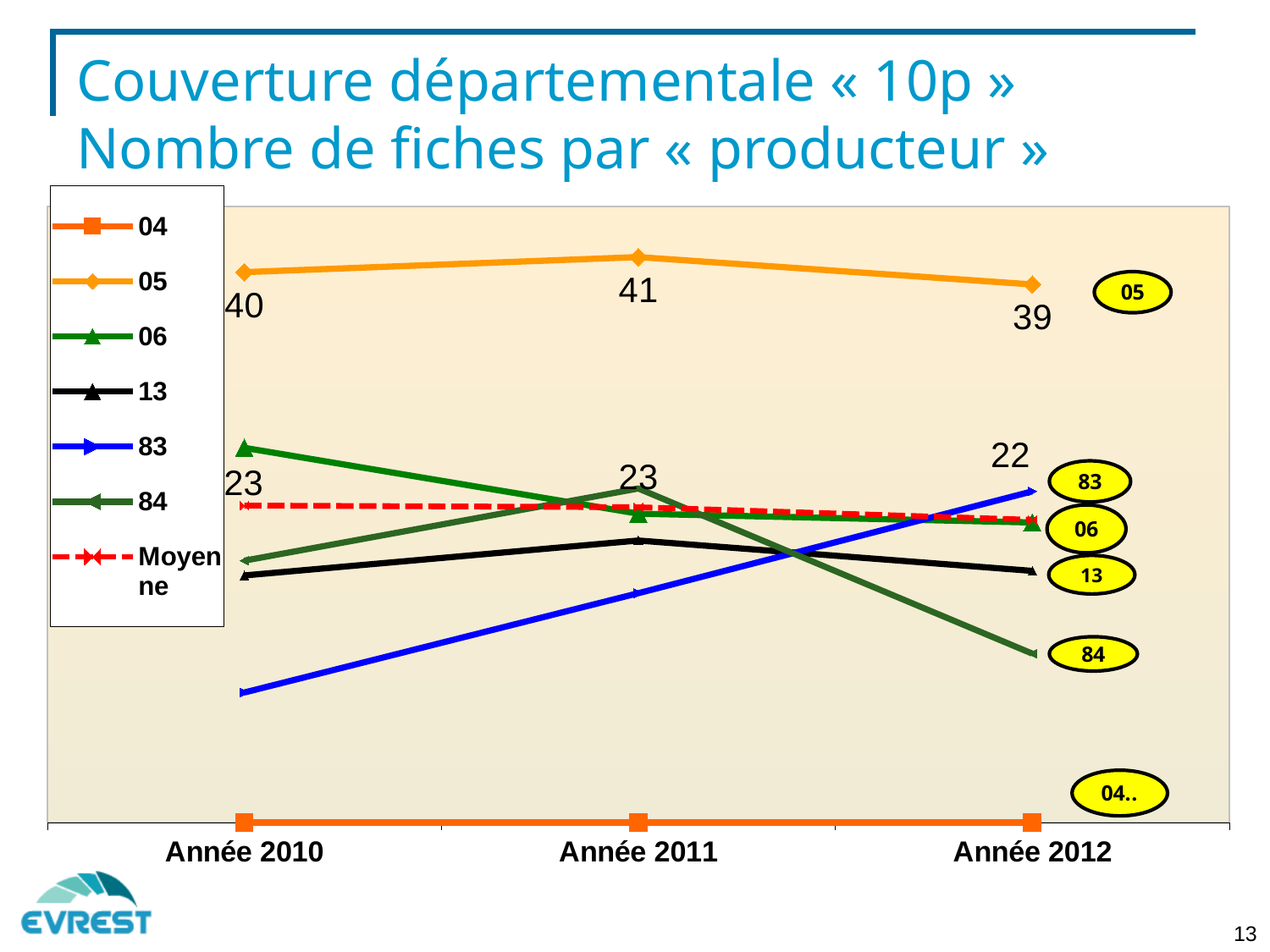
In which year does series 05 have its lowest value? Année 2012 How many series does the legend list? 7 What is the value for series 05 in Année 2010? 40 What is the value for series 05 in Année 2011? 41 Which series has the highest values across all three years? 05 In which year does series 05 reach its highest value? Année 2011 What type of chart is shown on the slide? line chart What is the value for series 05 in Année 2012? 39 Which series is drawn as a red dashed line? Moyenne How many years are shown on the x axis? 3 Does series 83 rise or fall from Année 2010 to Année 2012? rise What is the difference between the value of series 05 in Année 2011 and in Année 2012? 2